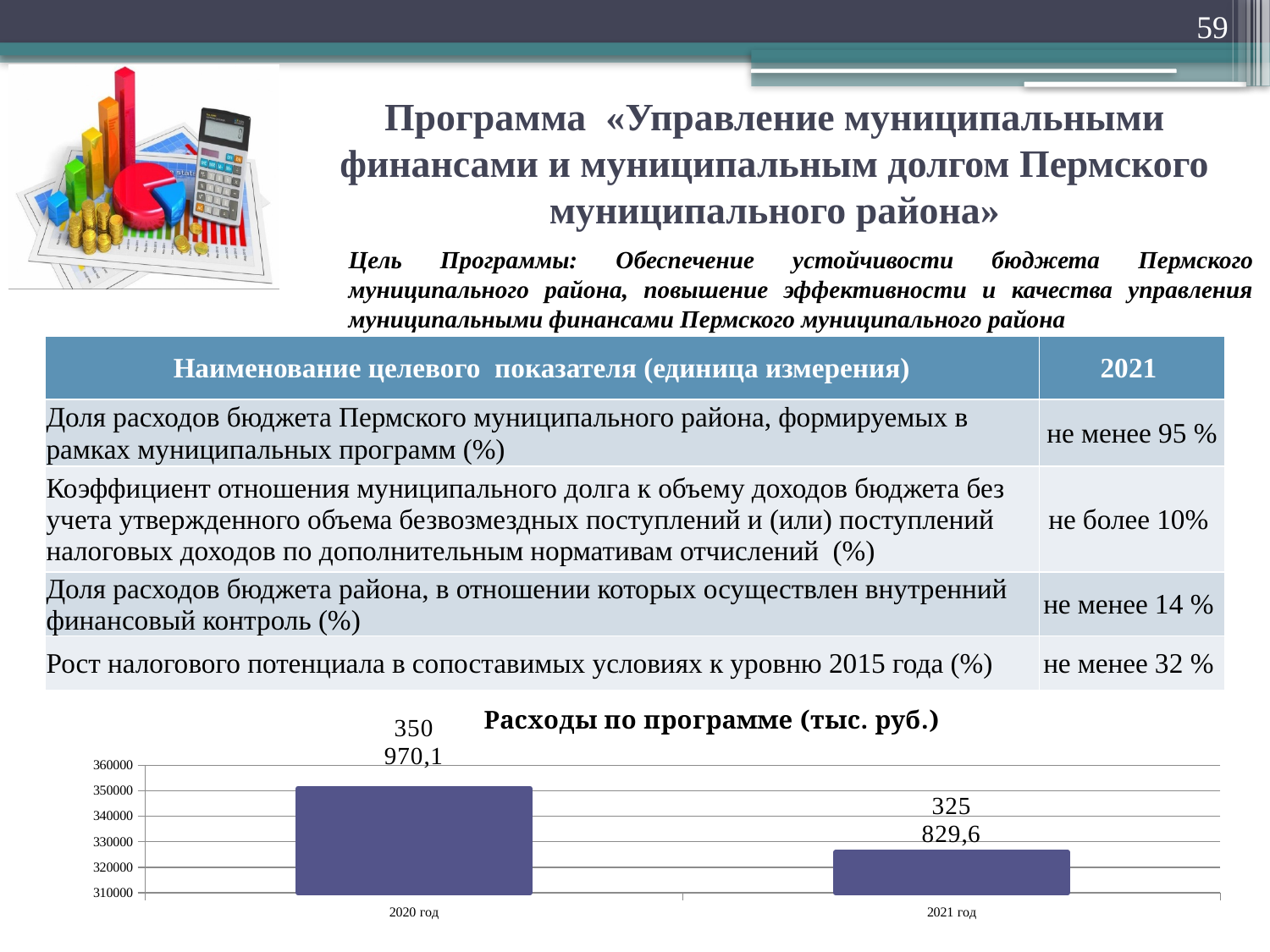
What is the title of the chart at the bottom of the slide? Расходы по программе (тыс. руб.) In the chart 'Расходы по программе (тыс. руб.)', what is the difference between the values for 2020 год and 2021 год? 25 140,5 In the chart 'Расходы по программе (тыс. руб.)', which year has the highest value? 2020 год How many categories are plotted in the chart 'Расходы по программе (тыс. руб.)'? 2 In the chart 'Расходы по программе (тыс. руб.)', which is larger: the value for 2020 год or for 2021 год? 2020 год In the chart 'Расходы по программе (тыс. руб.)', is the value for 2021 год greater or less than 330000? less In the chart 'Расходы по программе (тыс. руб.)', do the values rise or fall from 2020 год to 2021 год? fall In the chart 'Расходы по программе (тыс. руб.)', is the value for 2020 год greater or less than 340000? greater In the chart 'Расходы по программе (тыс. руб.)', which year has the lowest value? 2021 год In the chart 'Расходы по программе (тыс. руб.)', what is the value for 2020 год? 350 970,1 In the chart 'Расходы по программе (тыс. руб.)', what is the value for 2021 год? 325 829,6 What type of chart is shown at the bottom of the slide? bar chart